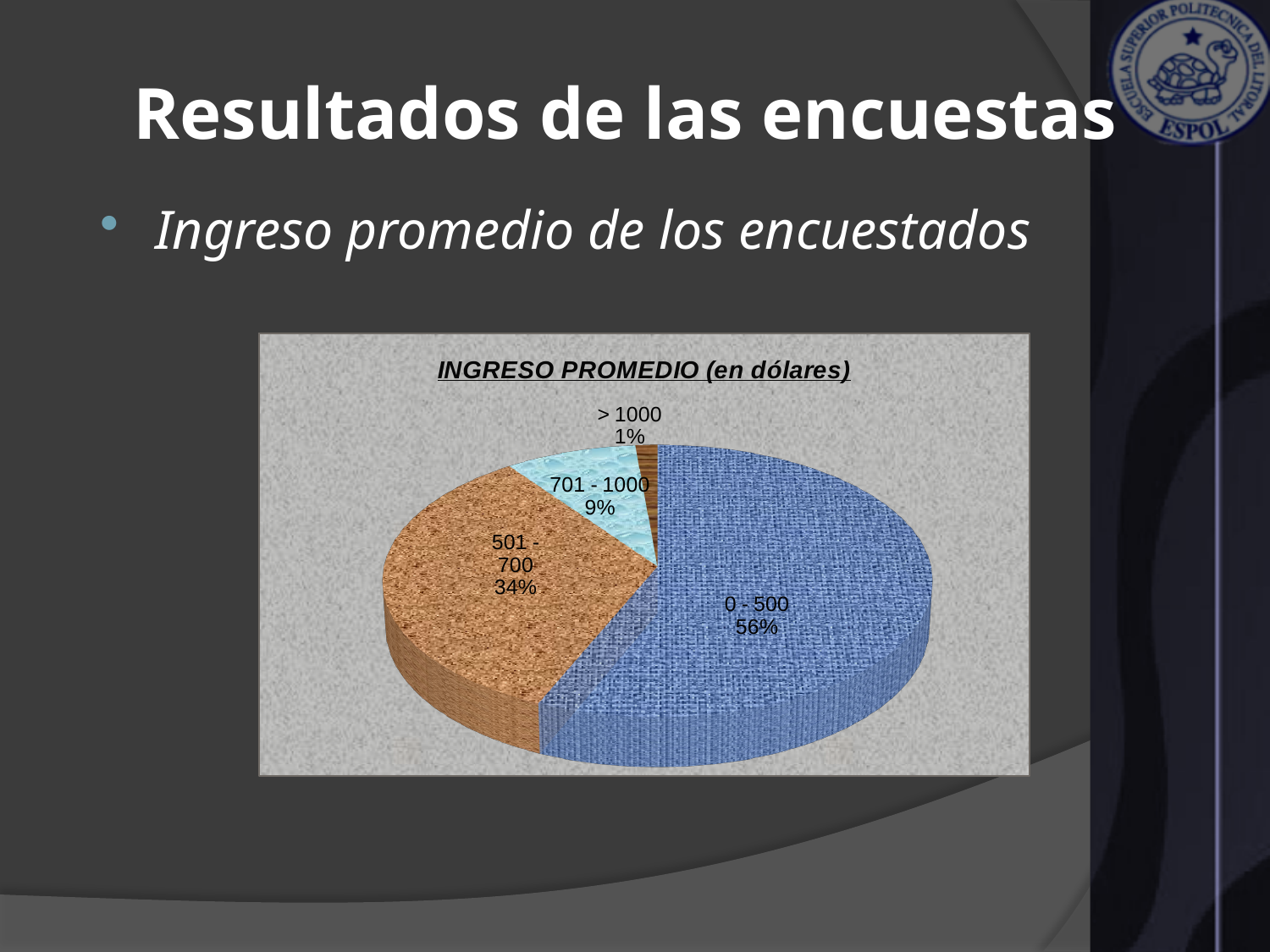
What share of the pie does the 501 - 700 slice represent? 34% What kind of chart is shown on the slide? Pie chart How many slices does the pie chart have? 4 What share of the pie does the 701 - 1000 slice represent? 9% What share of the pie does the > 1000 slice represent? 1% What is the title of the chart? INGRESO PROMEDIO (en dólares) What is the difference in percentage points between the 0 - 500 slice and the 501 - 700 slice? 22 What is the difference in percentage points between the 701 - 1000 slice and the > 1000 slice? 8 Which income range has the smallest share of the pie? > 1000 Which slice is larger, 501 - 700 or 701 - 1000? 501 - 700 Which income range has the largest share of the pie? 0 - 500